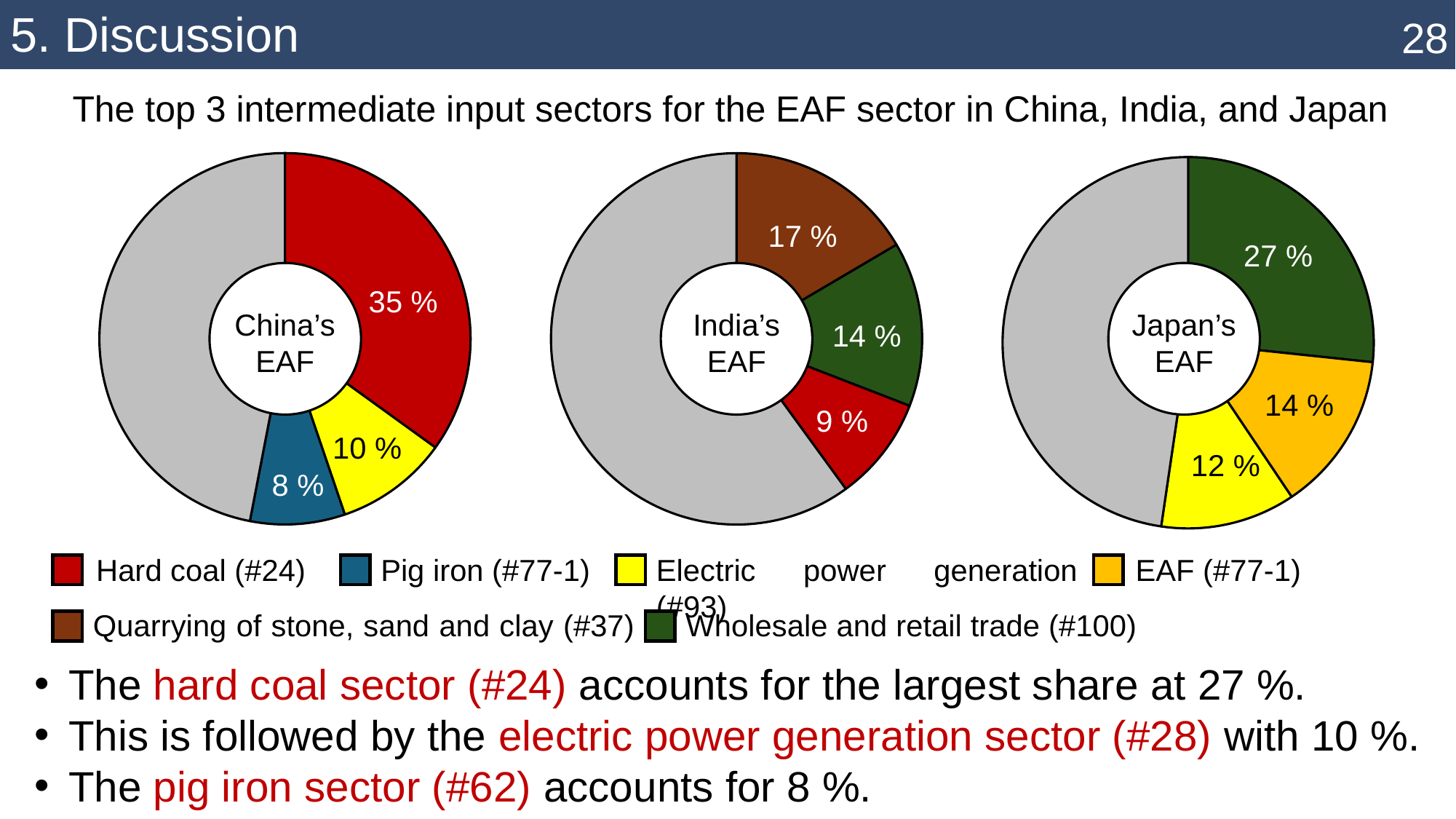
Is the share of Wholesale and retail trade (#100) larger in the India's EAF chart or the Japan's EAF chart? Japan's EAF What type of chart is used to show the top 3 intermediate input sectors for each country? Pie (donut) chart In the India's EAF chart, what share does Quarrying of stone, sand and clay (#37) account for? 17 % In the Japan's EAF chart, which labelled sector has the largest share? Wholesale and retail trade (#100) What colour represents Electric power generation (#93) in the legend? Yellow In the Japan's EAF chart, what share does Wholesale and retail trade (#100) account for? 27 % In the China's EAF chart, what is the difference between the Hard coal (#24) share and the Electric power generation (#93) share? 25 % In the China's EAF chart, what share does Hard coal (#24) account for? 35 % In the India's EAF chart, which labelled sector has the smallest share? Hard coal (#24) In the China's EAF chart, what share does Pig iron (#77-1) account for? 8 % In the Japan's EAF chart, what share does EAF (#77-1) account for? 14 % How many labelled sectors are shown in the India's EAF chart? 3